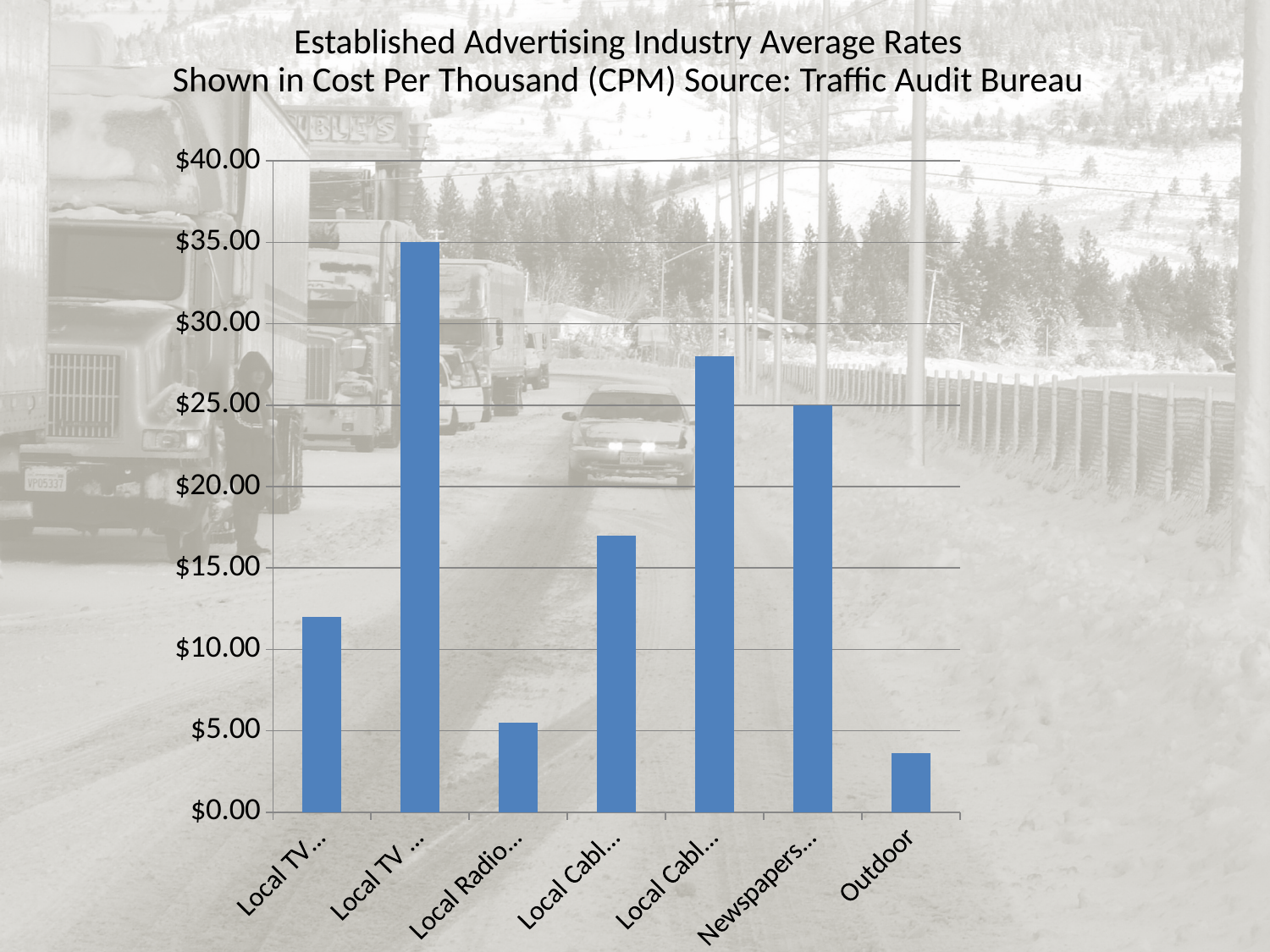
Is the value of the third bar from the left (Local Radio) greater or less than $10.00? less Is the value of the fifth bar from the left greater or less than $25.00? greater Is the value for Outdoor greater or less than $5.00? less Which category has the lowest value in the chart? Outdoor What is the value of the tallest bar (the second bar from the left)? $35.00 Which is larger, the value for Newspapers or the value for Outdoor? Newspapers What is the value of the Newspapers bar? $25.00 How many bars (categories) does the chart show? 7 What is the difference between the tallest bar ($35.00) and the Newspapers bar? $10.00 According to the chart title, what is the source of the data? Traffic Audit Bureau What kind of chart is shown on the slide? bar chart